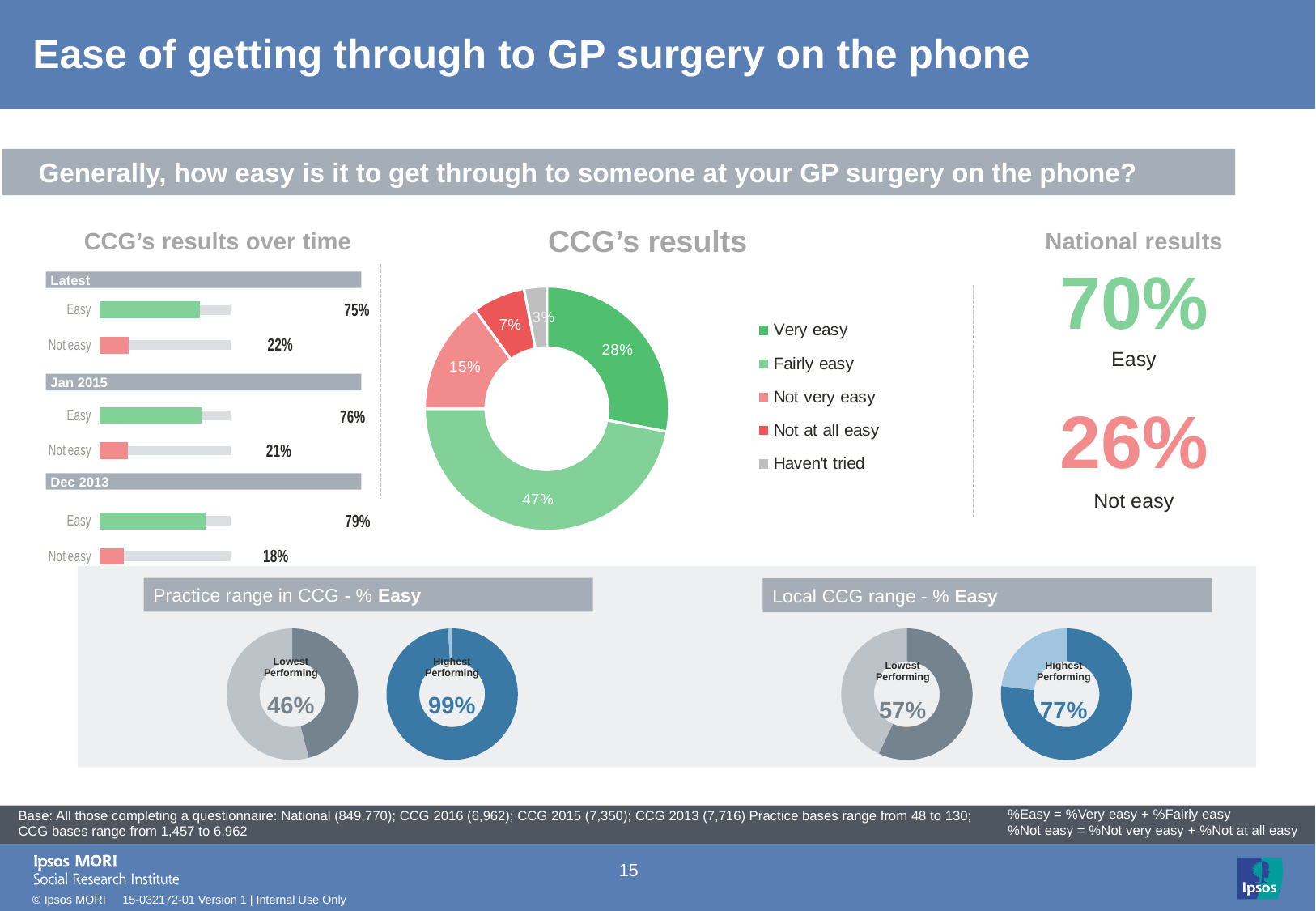
In the 'CCG's results' donut chart, what percentage answered 'Very easy'? 28% In the 'CCG's results' donut chart, which response category has the largest share? Fairly easy In the 'Practice range in CCG - % Easy' section, what is the Highest Performing value? 99% What kind of chart is used for 'CCG's results'? Donut chart In the 'CCG's results' donut chart, which response category has the smallest share? Haven't tried How many entries does the legend of the 'CCG's results' donut chart list? 5 In the 'Local CCG range - % Easy' section, what is the difference between the Highest Performing and Lowest Performing values? 20% In the 'CCG's results' donut chart, what percentage answered 'Fairly easy'? 47% In the 'CCG's results over time' chart, how does the 'Easy' percentage change from Dec 2013 to Latest? It falls (79% to 76% to 75%) In the 'CCG's results' donut chart, what is the difference between the 'Not very easy' and 'Not at all easy' shares? 8% In the 'CCG's results over time' chart, what is the 'Not easy' value for the Latest period? 22% In the 'CCG's results over time' chart, what is the 'Easy' value for Dec 2013? 79%